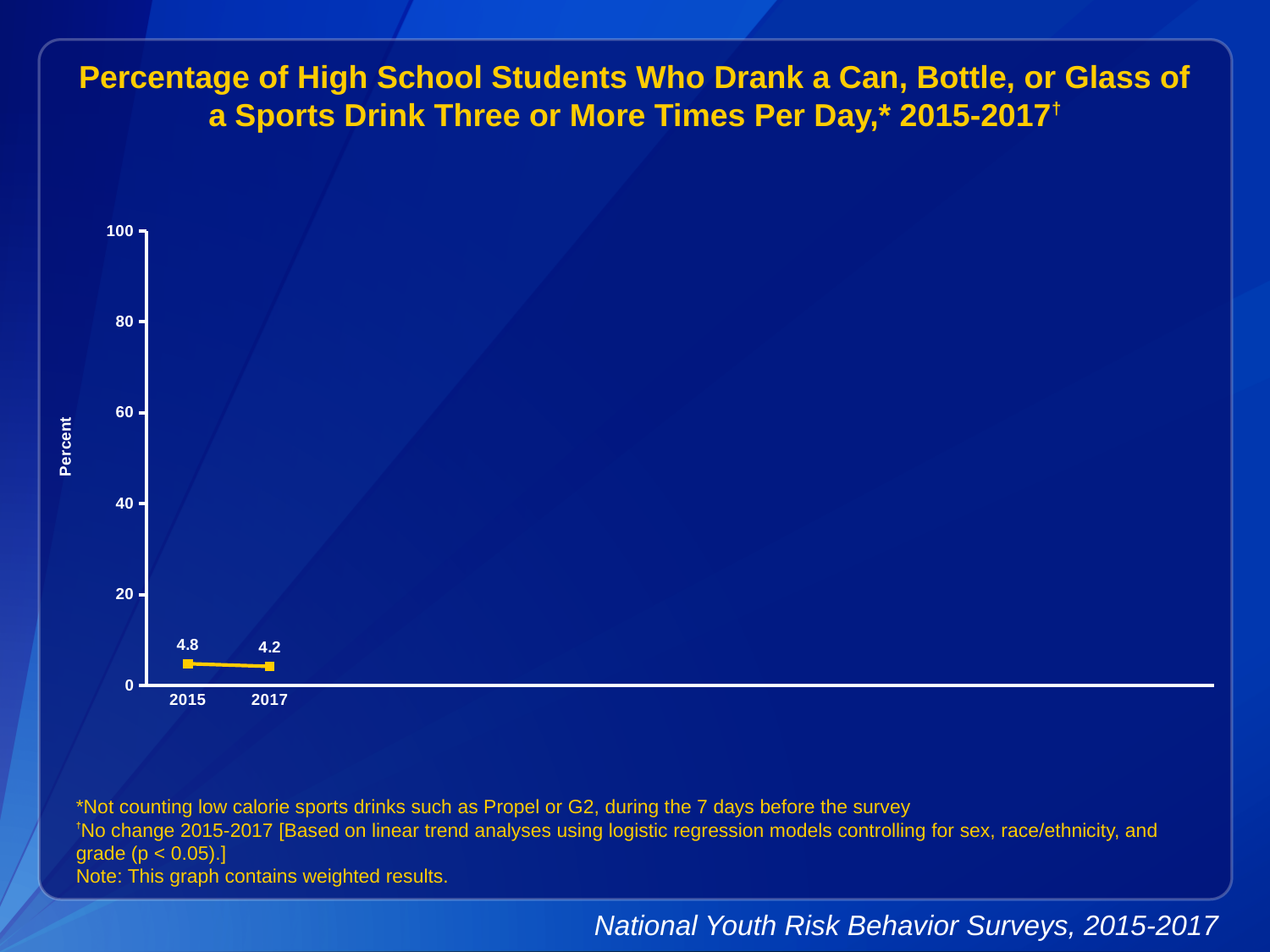
What is the label on the y axis? Percent Do the values rise or fall from 2015 to 2017? fall Is the value for 2015 greater or less than 20? less What is the difference between the 2015 and 2017 values? 0.6 What is the value for 2017? 4.2 Which year has the higher value? 2015 What kind of chart is shown on the slide? line chart What is the maximum value shown on the y axis? 100 How many data points are plotted on the chart? 2 Which year has the lower value? 2017 What is the value for 2015? 4.8